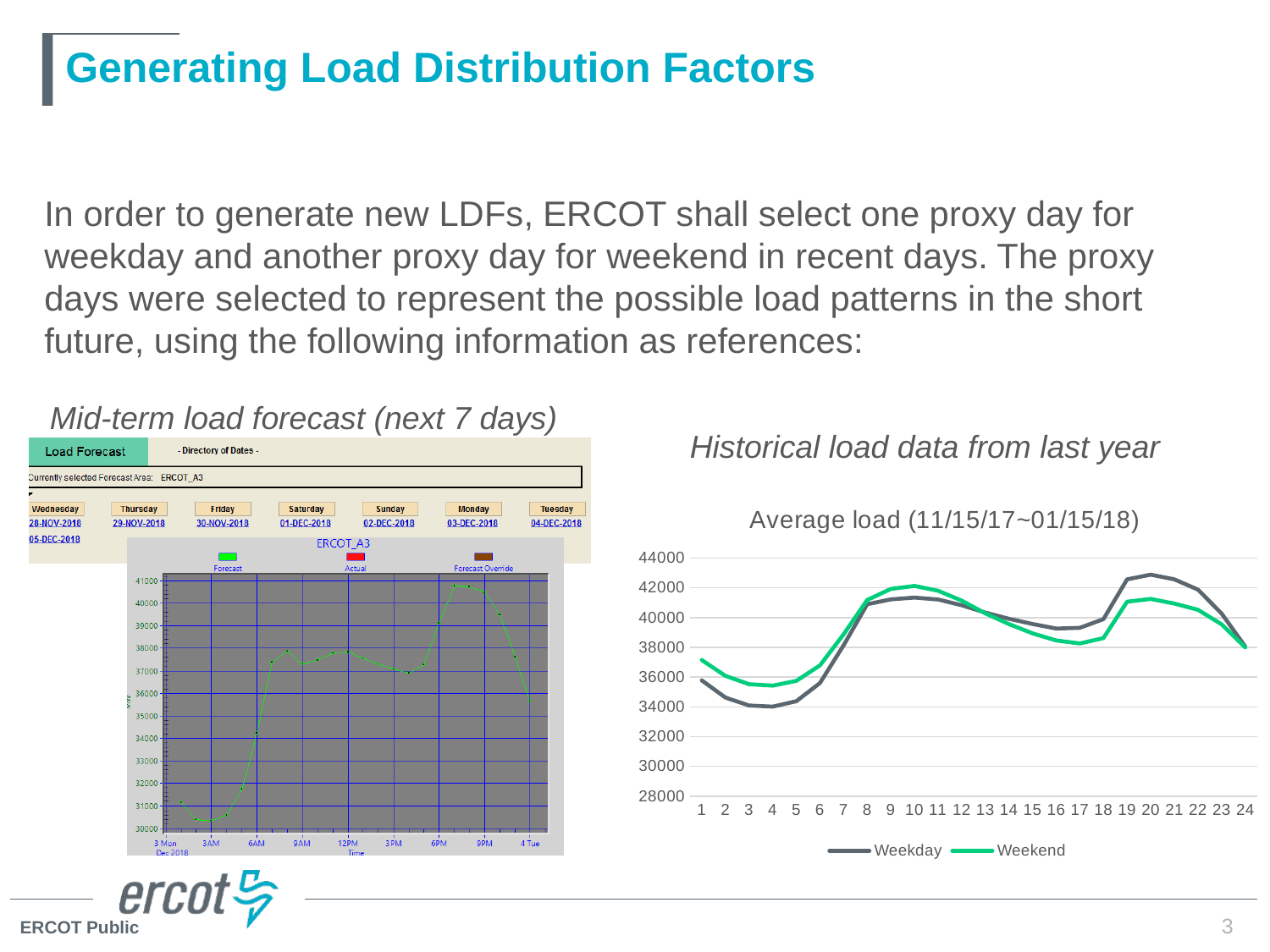
How many series does the legend of the 'Average load (11/15/17~01/15/18)' chart list? 2 What kind of chart is the 'Average load (11/15/17~01/15/18)' chart on the right? Line chart In the ERCOT_A3 load forecast chart on the left, is the forecast value at 9PM greater or less than 40000? greater In the 'Average load (11/15/17~01/15/18)' chart, is the Weekend value at hour 10 greater or less than 40000? greater What are the two legend entries of the 'Average load (11/15/17~01/15/18)' chart? Weekday and Weekend In the 'Average load (11/15/17~01/15/18)' chart, which series has the higher value at hour 10, Weekday or Weekend? Weekend In the 'Average load (11/15/17~01/15/18)' chart, is the Weekday value at hour 4 greater or less than 36000? less In the 'Average load (11/15/17~01/15/18)' chart, does the Weekday series rise or fall from hour 4 to hour 8? Rise In the 'Average load (11/15/17~01/15/18)' chart, at which hour does the Weekday series reach its highest value? 20 How many hourly points are shown along the x axis of the 'Average load (11/15/17~01/15/18)' chart? 24 In the 'Average load (11/15/17~01/15/18)' chart, which series has the higher value at hour 20, Weekday or Weekend? Weekday